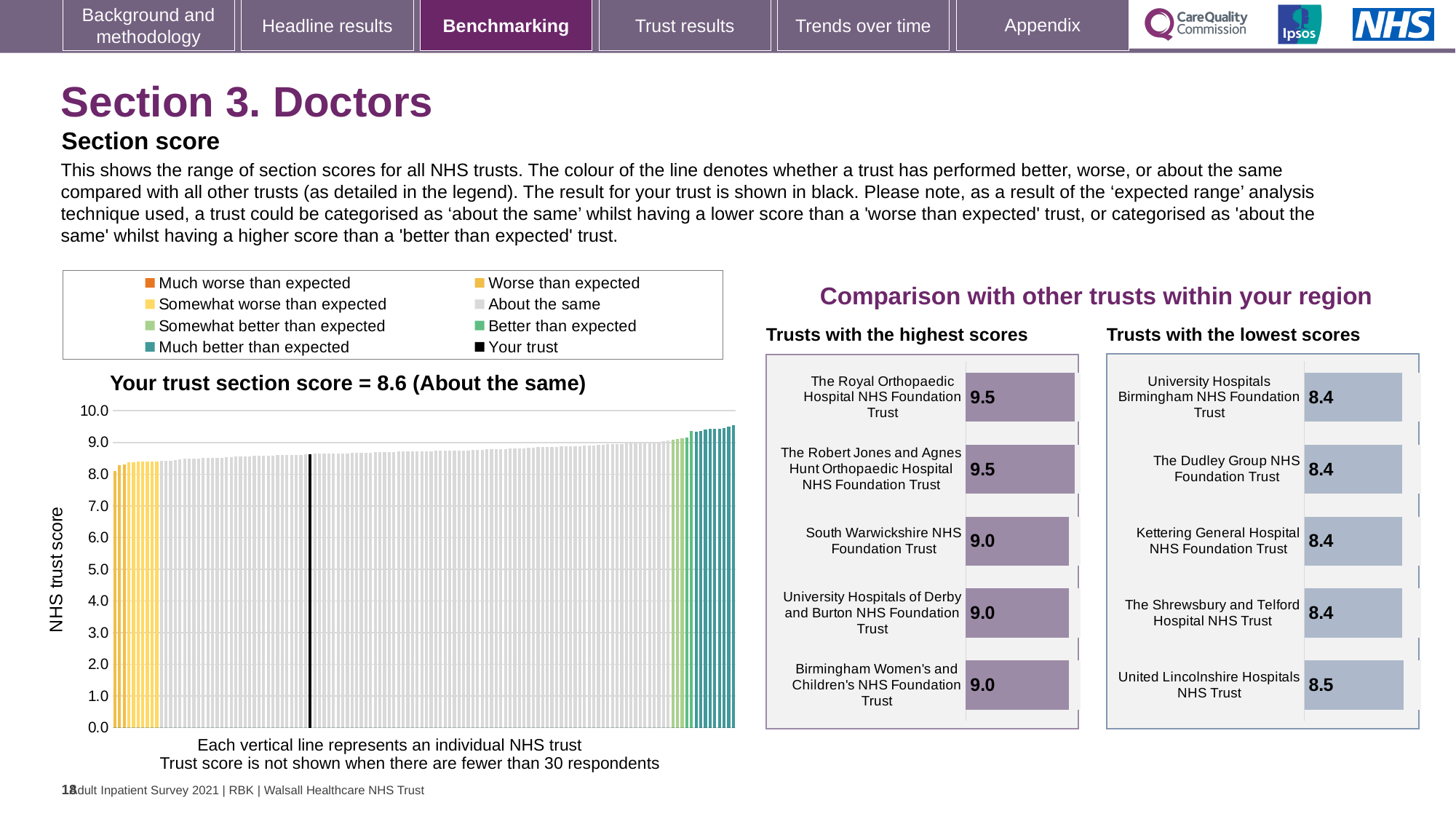
In the large chart on the left, how many entries does the legend list? 8 Which has the larger score: The Royal Orthopaedic Hospital NHS Foundation Trust in the 'Trusts with the highest scores' chart or University Hospitals Birmingham NHS Foundation Trust in the 'Trusts with the lowest scores' chart? The Royal Orthopaedic Hospital NHS Foundation Trust In the large chart on the left, do the trust scores rise or fall from left to right along the x axis? Rise In the large chart on the left, what is the label on the y axis? NHS trust score In the 'Trusts with the lowest scores' chart, which trust has the highest score? United Lincolnshire Hospitals NHS Trust In the 'Trusts with the highest scores' chart, what is the difference between the score for The Robert Jones and Agnes Hunt Orthopaedic Hospital NHS Foundation Trust and the score for South Warwickshire NHS Foundation Trust? 0.5 In the 'Trusts with the highest scores' chart, how many trusts are shown? 5 In the 'Trusts with the lowest scores' chart, what is the score for Kettering General Hospital NHS Foundation Trust? 8.4 In the large chart on the left, what is the section score for your trust? 8.6 What kind of chart is the large chart on the left showing the range of section scores for all NHS trusts? Bar chart In the 'Trusts with the highest scores' chart, what is the score for The Royal Orthopaedic Hospital NHS Foundation Trust? 9.5 In the large chart on the left, is the score of the rightmost (highest) trust greater or less than 9.0? greater